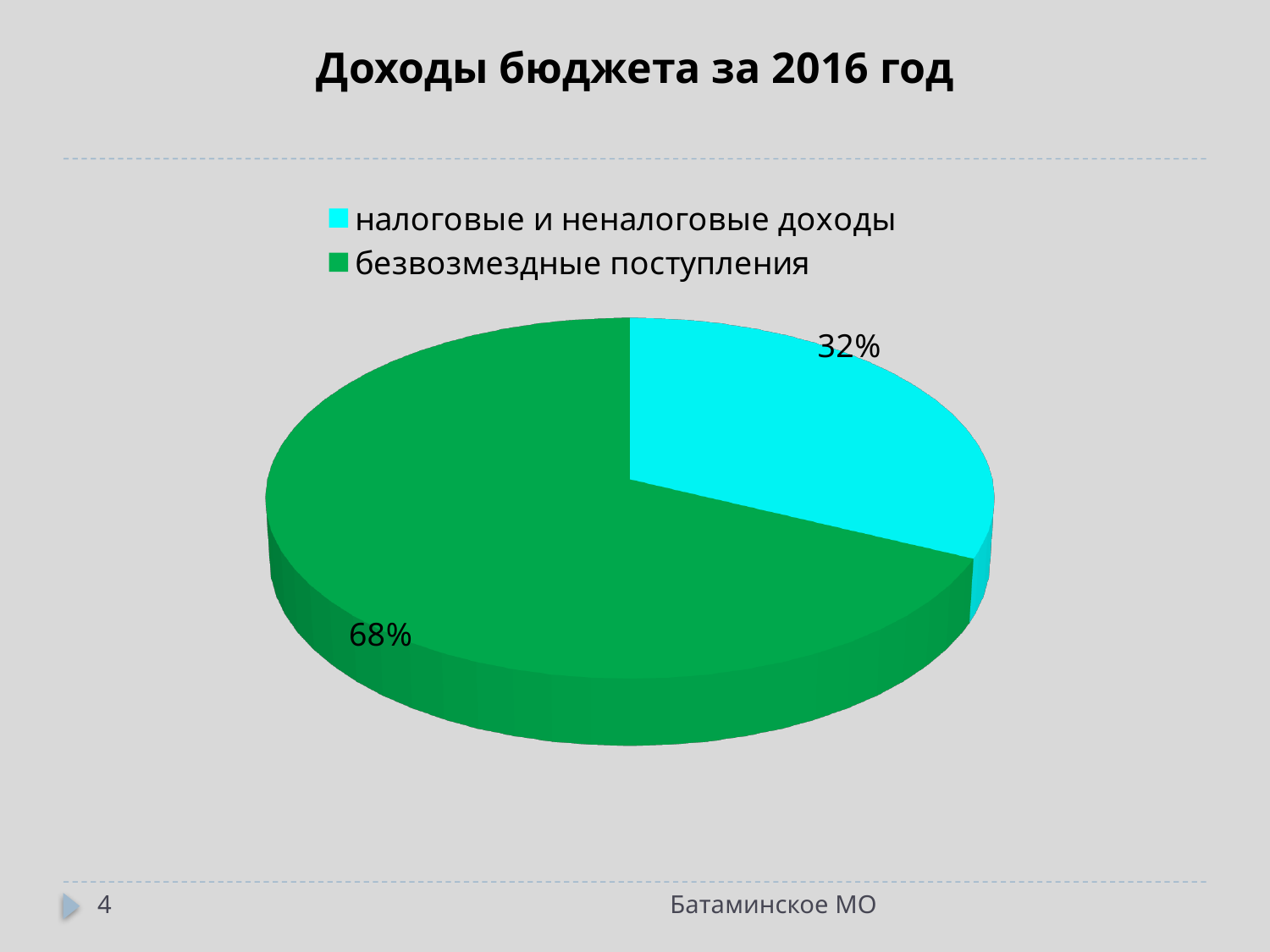
Is the share for налоговые и неналоговые доходы greater or less than 50%? less Which category has the largest slice of the pie? безвозмездные поступления What colour is the slice for безвозмездные поступления? green What share of the pie does the slice for безвозмездные поступления represent? 68% How many entries does the legend list? 2 What is the title of the slide? Доходы бюджета за 2016 год What is the difference in percentage points between the slice for безвозмездные поступления and the slice for налоговые и неналоговые доходы? 36 What share of the pie does the slice for налоговые и неналоговые доходы represent? 32% What kind of chart is shown on the slide? pie chart How many slices does the pie chart have? 2 Which is larger: the slice for налоговые и неналоговые доходы or the slice for безвозмездные поступления? безвозмездные поступления Which category has the smallest slice of the pie? налоговые и неналоговые доходы